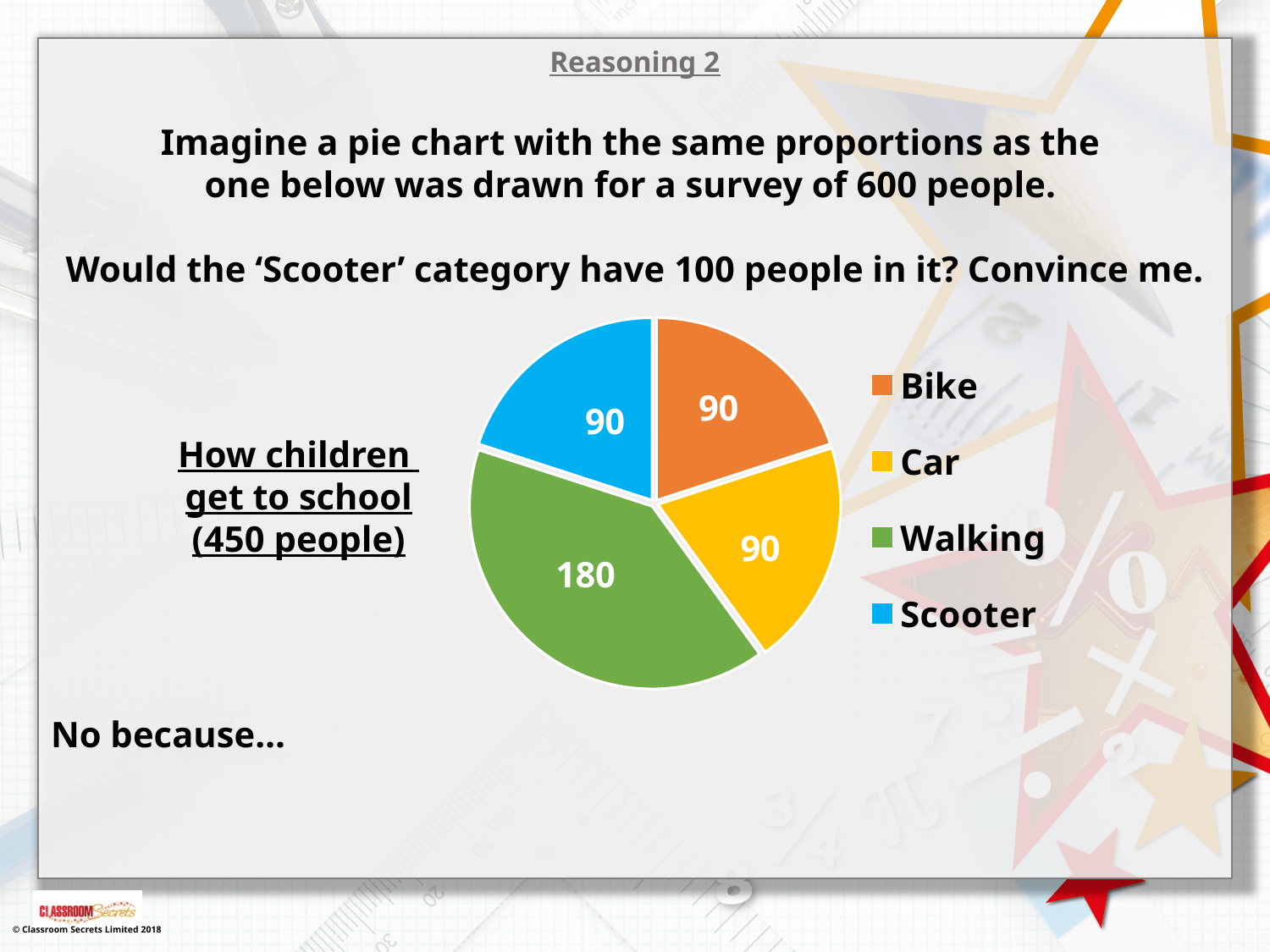
What is the value for Walking in the pie chart? 180 What is the difference between the values for Walking and Bike? 90 What type of chart is shown on the slide? pie chart How many entries does the legend list? 4 What colour is the Scooter slice in the pie chart? blue Which is larger, the value for Walking or the value for Car? Walking What share of the pie chart does the Walking slice represent? 40% What is the value for Scooter in the pie chart? 90 What is the total of all the slices in the pie chart? 450 What is the value for Bike in the pie chart? 90 Which category has the largest slice of the pie chart? Walking How many categories does the pie chart show? 4